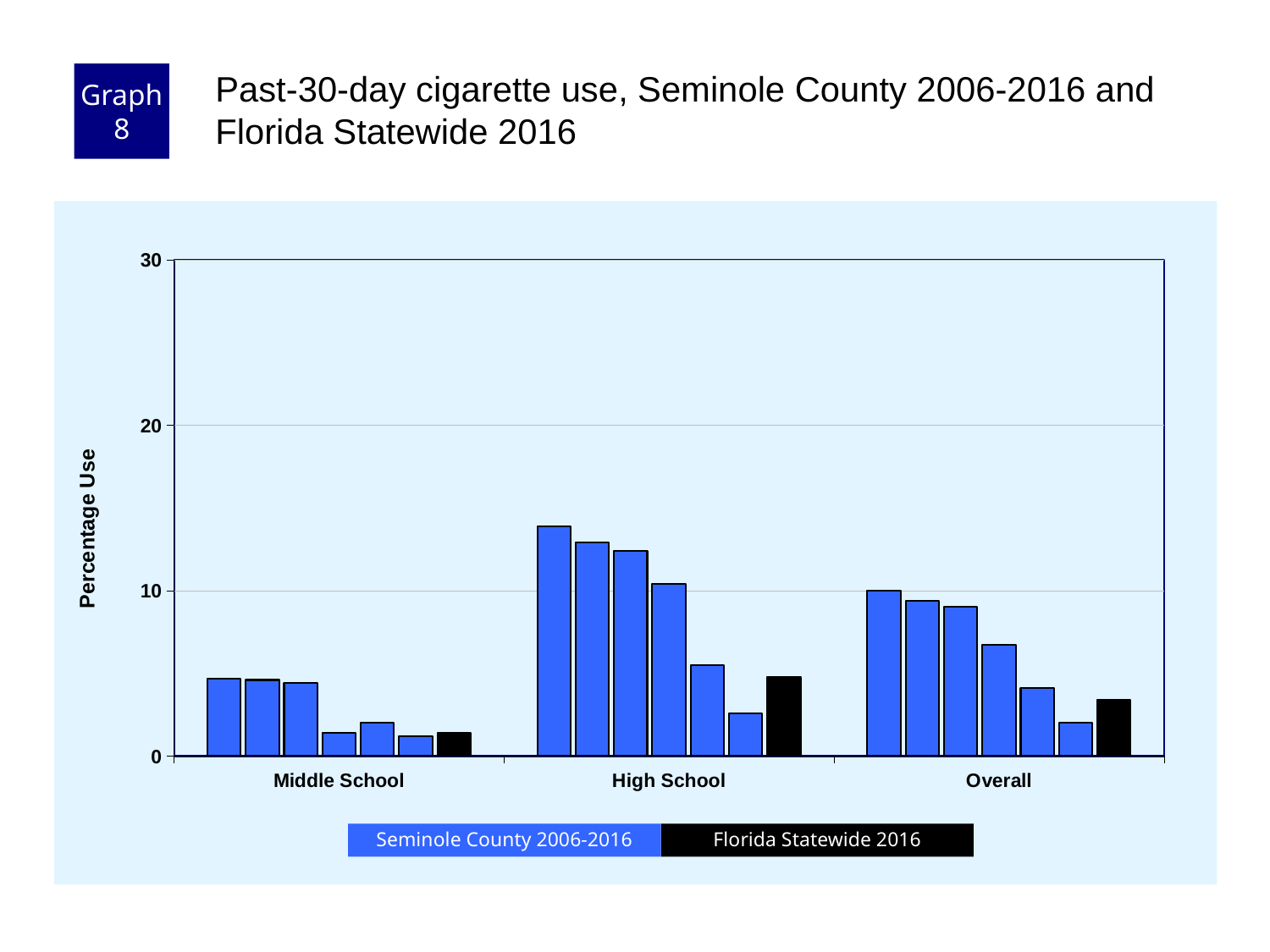
Which colour represents Florida Statewide 2016 in the legend? black Which category has the tallest bar in the chart? High School Is the Florida Statewide 2016 bar for High School greater or less than 10? less How many series does the legend list? 2 Is the tallest Seminole County bar for Middle School greater or less than 10? less What is the label on the y axis? Percentage Use How many categories are shown on the x axis? 3 Within the High School group, do the Seminole County 2006-2016 bars rise or fall from left to right? fall What kind of chart is shown on the slide? bar chart Is the tallest Seminole County bar for High School greater or less than 10? greater Which is larger, the Florida Statewide 2016 bar for High School or the Florida Statewide 2016 bar for Overall? High School Which is larger, the Florida Statewide 2016 bar for High School or the Florida Statewide 2016 bar for Middle School? High School